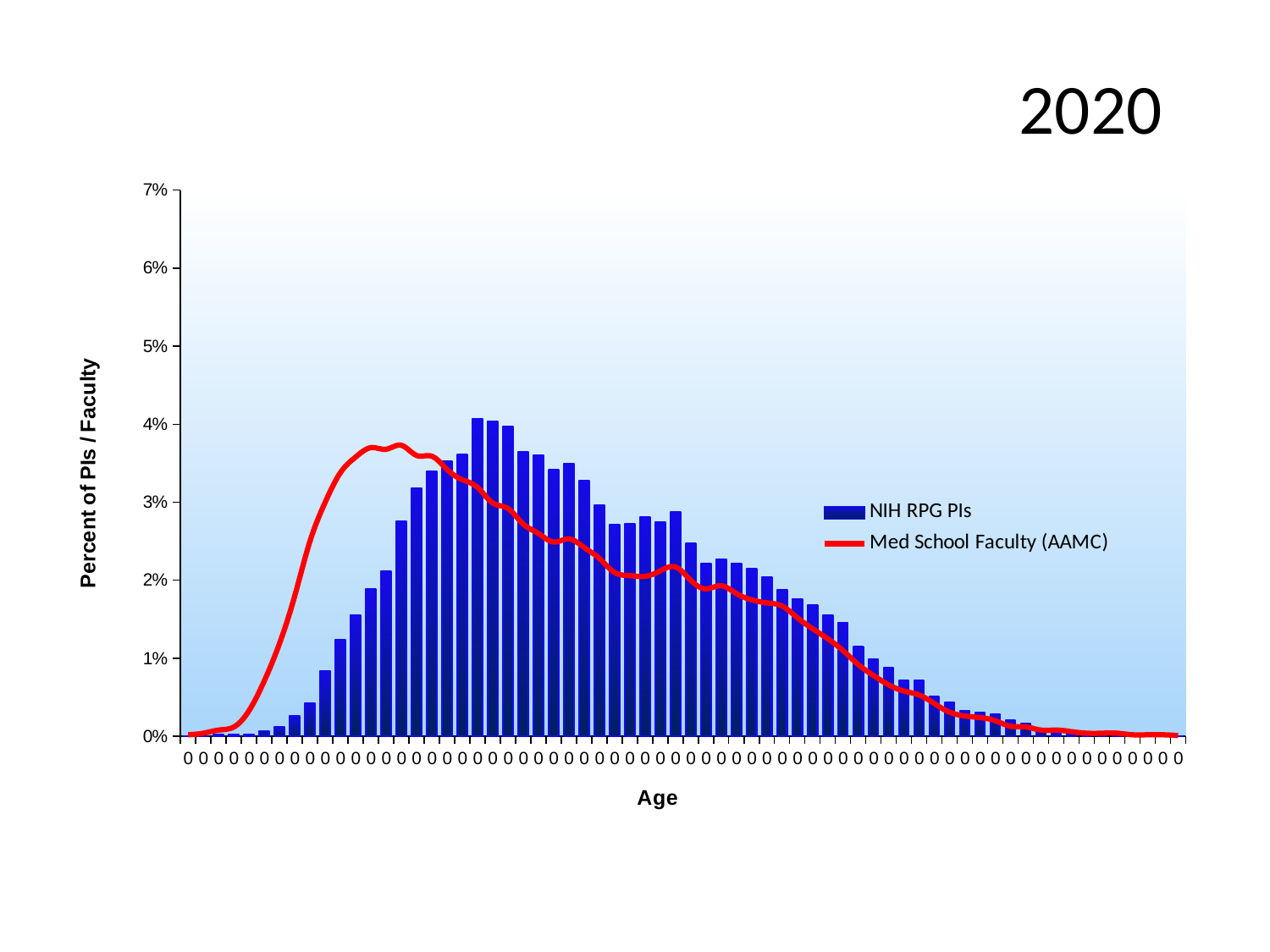
Which series reaches a higher peak value, NIH RPG PIs or Med School Faculty (AAMC)? NIH RPG PIs How many series does the legend list? 2 Is the tallest NIH RPG PIs bar greater or less than 5%? less Is the value of the Med School Faculty (AAMC) line at the far right end of the Age axis greater or less than 1%? less What kind of chart is shown on the slide? A combination of a bar chart and a line chart Is the tallest NIH RPG PIs bar greater or less than 3%? greater What is the title of the vertical axis? Percent of PIs / Faculty What are the two entries in the chart legend? NIH RPG PIs and Med School Faculty (AAMC) Toward the right end of the Age axis, do the NIH RPG PIs bar values rise or fall? fall